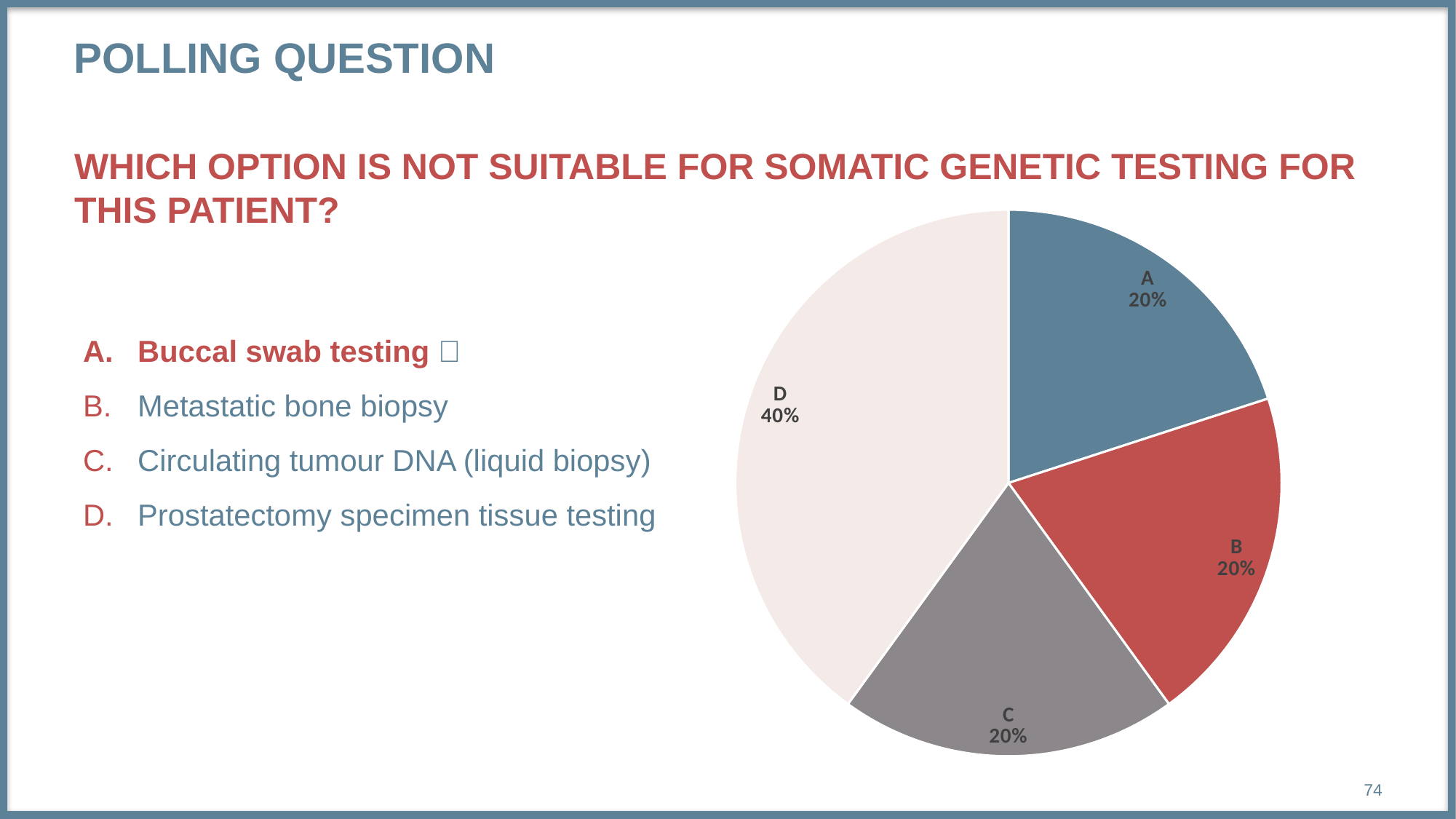
What kind of chart is shown on the slide? pie chart What percentage is shown for slice D in the pie chart? 40% Which is larger in the pie chart, slice D or slice A? D Which slice of the pie chart is the largest? D What colour is slice A in the pie chart? blue What percentage is shown for slice C in the pie chart? 20% What is the difference in percentage points between slice D and slice B? 20 What percentage is shown for slice A in the pie chart? 20% What colour is slice B in the pie chart? red What share of the pie does slice B represent? 20% How many slices does the pie chart have? 4 What is the combined percentage of slices A, B and C in the pie chart? 60%